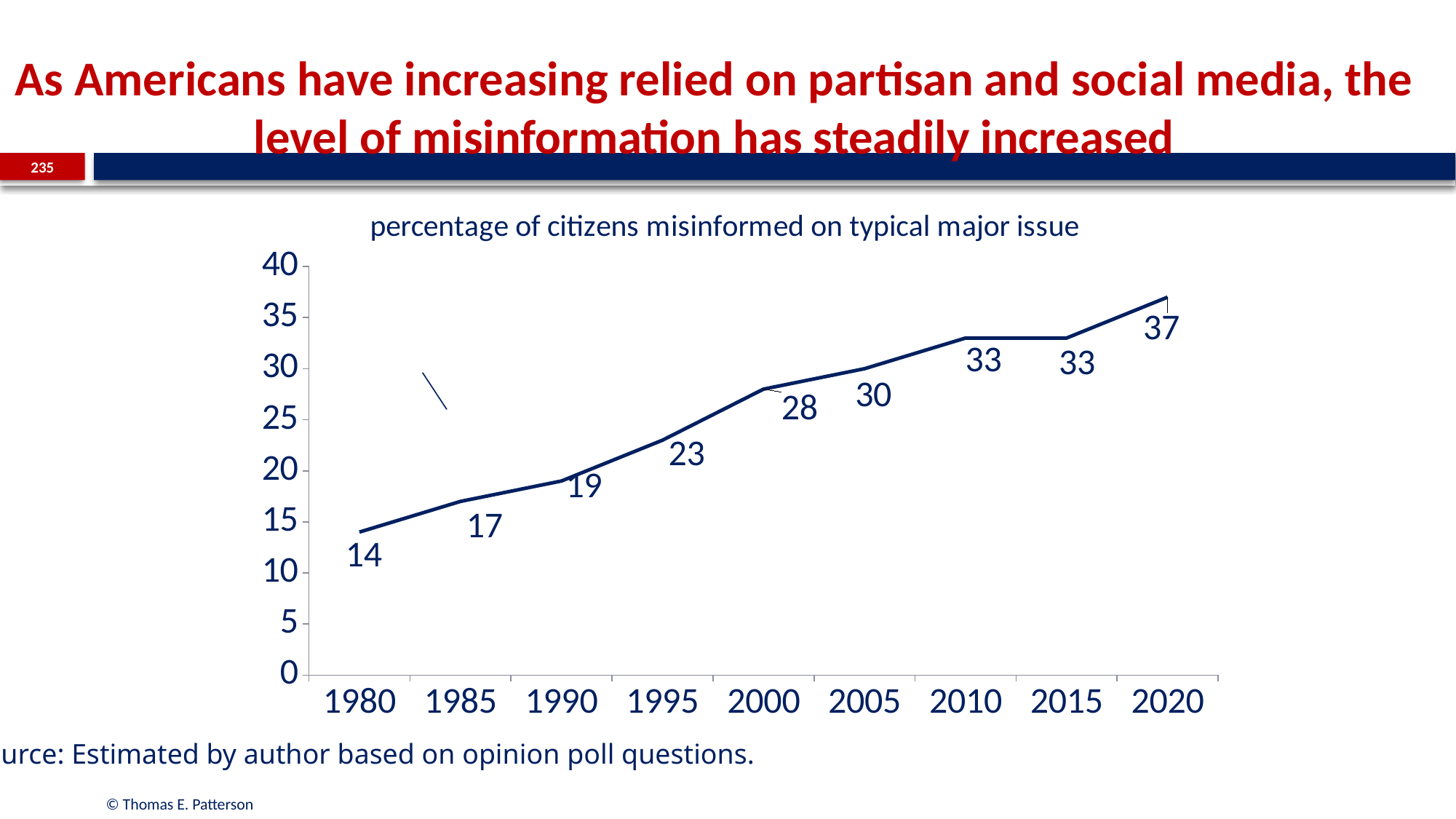
What kind of chart is shown on the slide? line chart What is the value for 2000? 28 What is the title of the chart? percentage of citizens misinformed on typical major issue Which year has the lowest value? 1980 What is the value for 2020? 37 What is the value for 1980? 14 Which year has the highest value? 2020 What is the difference between the values for 2020 and 1980? 23 Which is larger, the value for 1995 or the value for 2005? 2005 Do the values generally rise or fall from 1980 to 2020? rise Which two consecutive years have the same value? 2010 and 2015 How many data points are plotted on the chart? 9